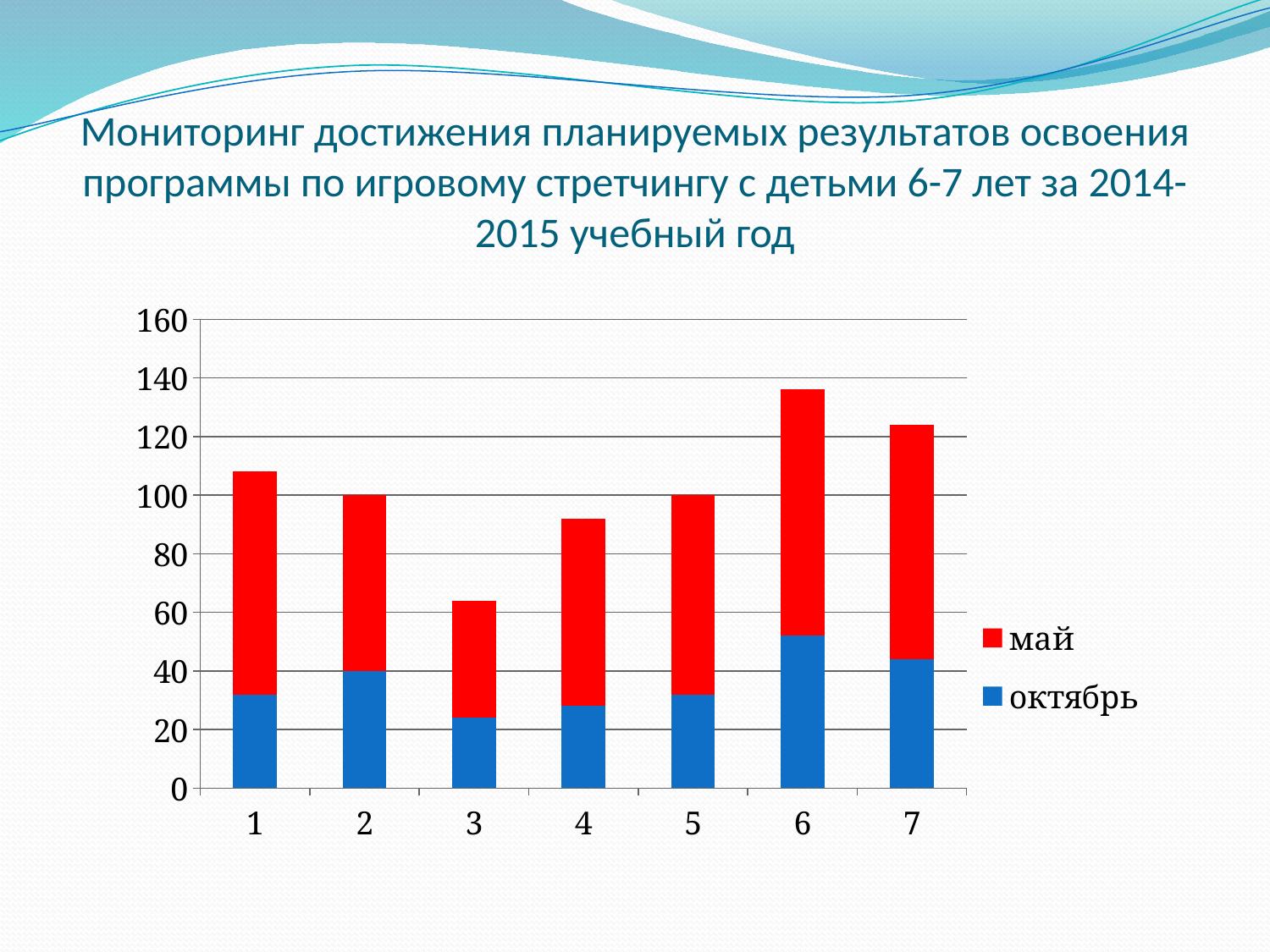
Is the total stacked value for category 3 greater or less than 80? less How many categories are shown on the x axis of the chart? 7 What kind of chart is shown on the slide? bar chart Which category has the shortest stacked bar? 3 Which stacked bar is taller, category 6 or category 7? 6 How many series does the chart legend list? 2 Is the total stacked value for category 1 greater or less than 100? greater Which stacked bar is taller, category 1 or category 4? 1 Is the октябрь value for category 6 greater or less than 40? greater Which category has the tallest stacked bar? 6 Which colour represents the май series in the legend? red